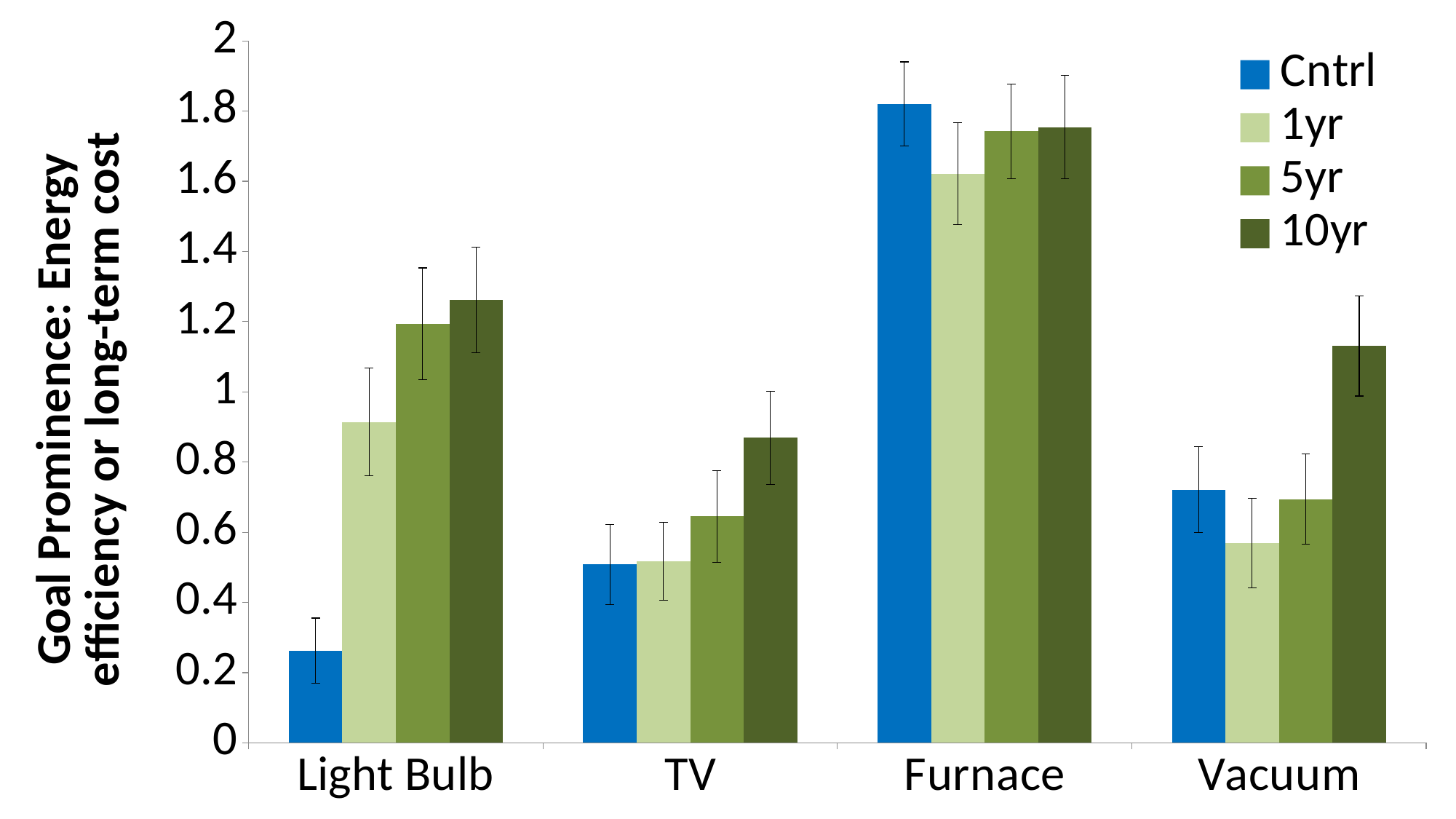
Is the 10yr value for TV greater or less than 0.8? greater What is the title of the y axis? Goal Prominence: Energy efficiency or long-term cost For Furnace, which series has the lowest value? 1yr What kind of chart is shown on the slide? bar chart Is the Cntrl value for Light Bulb greater or less than 0.4? less Which category has the lowest Cntrl value? Light Bulb Which category has the highest Cntrl value? Furnace How many series does the legend list? 4 Is the Cntrl value for Furnace greater or less than 1.6? greater For Light Bulb, which is larger: the Cntrl value or the 10yr value? 10yr How many product categories are shown on the x axis? 4